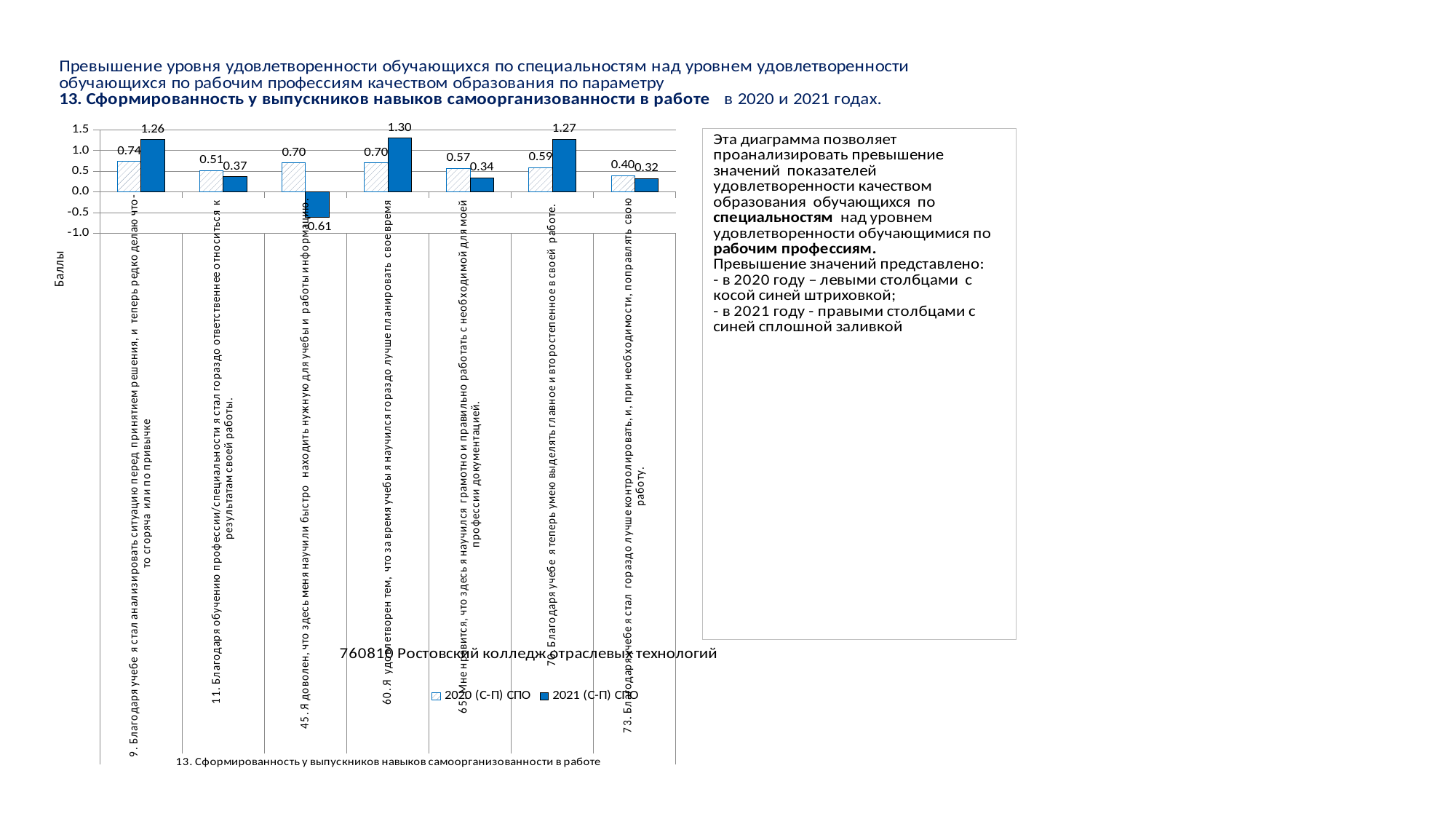
Which statement has the highest 2021 (С-П) СПО value? 60. Я удовлетворен тем, что за время учебы я научился гораздо лучше планировать свое время Which statement has the lowest 2020 (С-П) СПО value? 73. Благодаря учебе я стал гораздо лучше контролировать, и, при необходимости, поправлять свою работу What is the difference between the 2021 and 2020 (С-П) СПО values for statement 70 ("Благодаря учебе я теперь умею выделять главное и второстепенное в своей работе")? 0.68 What is the 2021 (С-П) СПО value for statement 9 ("Благодаря учебе я стал анализировать ситуацию перед принятием решения...")? 1.26 What type of chart is shown on the slide? bar chart How many categories (statements) are plotted on the chart? 7 Is the 2021 (С-П) СПО value for statement 60 greater or less than 1.0? greater What is the label of the vertical axis of the chart? Баллы How many series does the chart legend list? 2 What is the 2020 (С-П) СПО value for statement 45 ("Я доволен, что здесь меня научили быстро находить нужную для учебы и работы информацию")? 0.70 For statement 11 ("Благодаря обучению профессии/специальности я стал гораздо ответственнее относиться к результатам своей работы"), which series has the larger value, 2020 (С-П) СПО or 2021 (С-П) СПО? 2020 (С-П) СПО What is the 2021 (С-П) СПО value for statement 45 ("Я доволен, что здесь меня научили быстро находить нужную для учебы и работы информацию")? -0.61